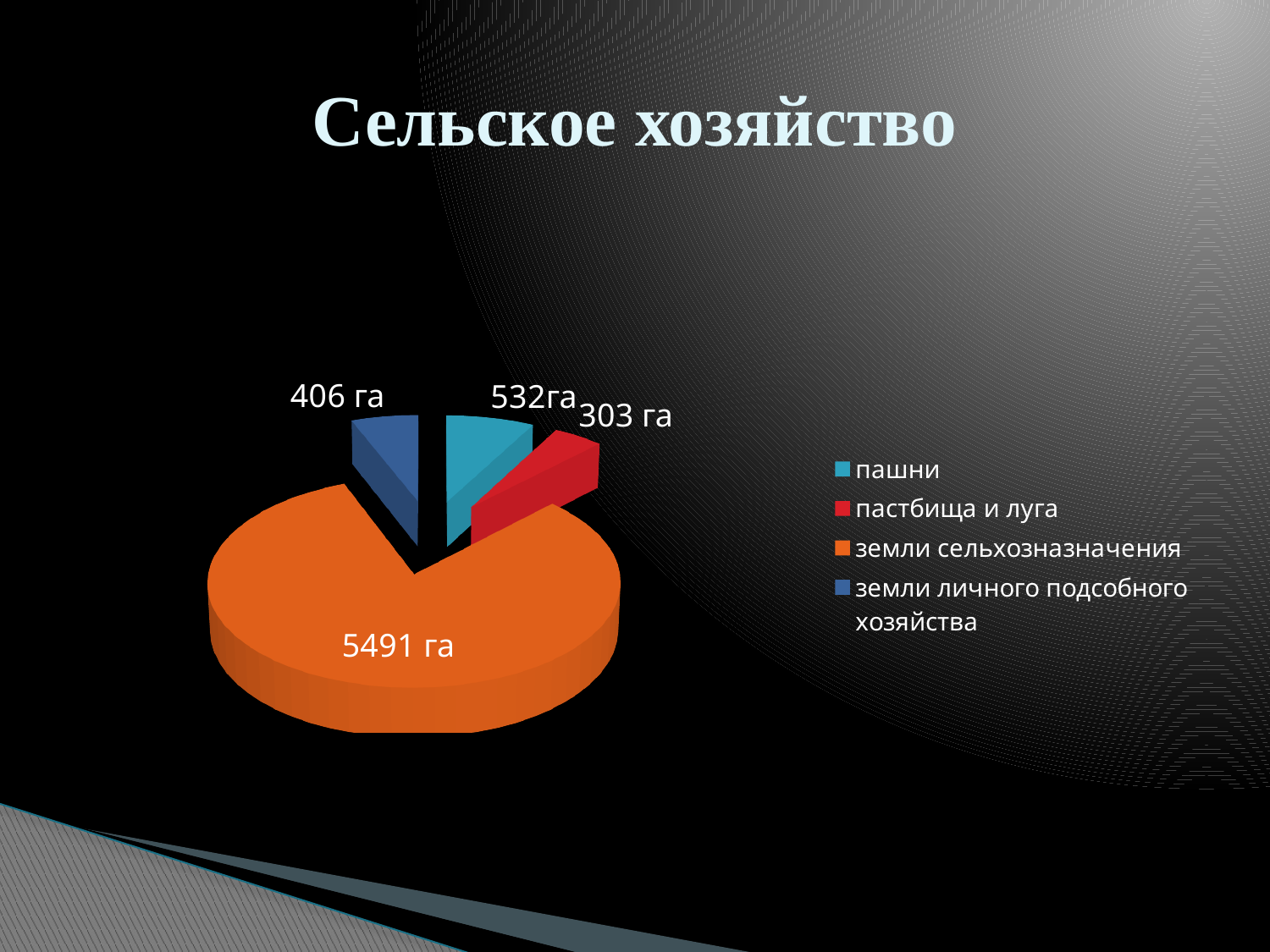
Which category has the largest slice of the pie? земли сельхозназначения Which is larger, the value for земли личного подсобного хозяйства or the value for пастбища и луга? земли личного подсобного хозяйства What is the value for земли личного подсобного хозяйства? 406 га What colour is the slice for земли сельхозназначения? orange What kind of chart is shown on the slide? pie chart Which category has the smallest slice of the pie? пастбища и луга What is the value for пашни? 532га What is the value for земли сельхозназначения? 5491 га What is the difference between the values for пашни and пастбища и луга? 229 га How many categories does the pie chart show? 4 What is the total of all four slices of the pie? 6732 га What is the value for пастбища и луга? 303 га